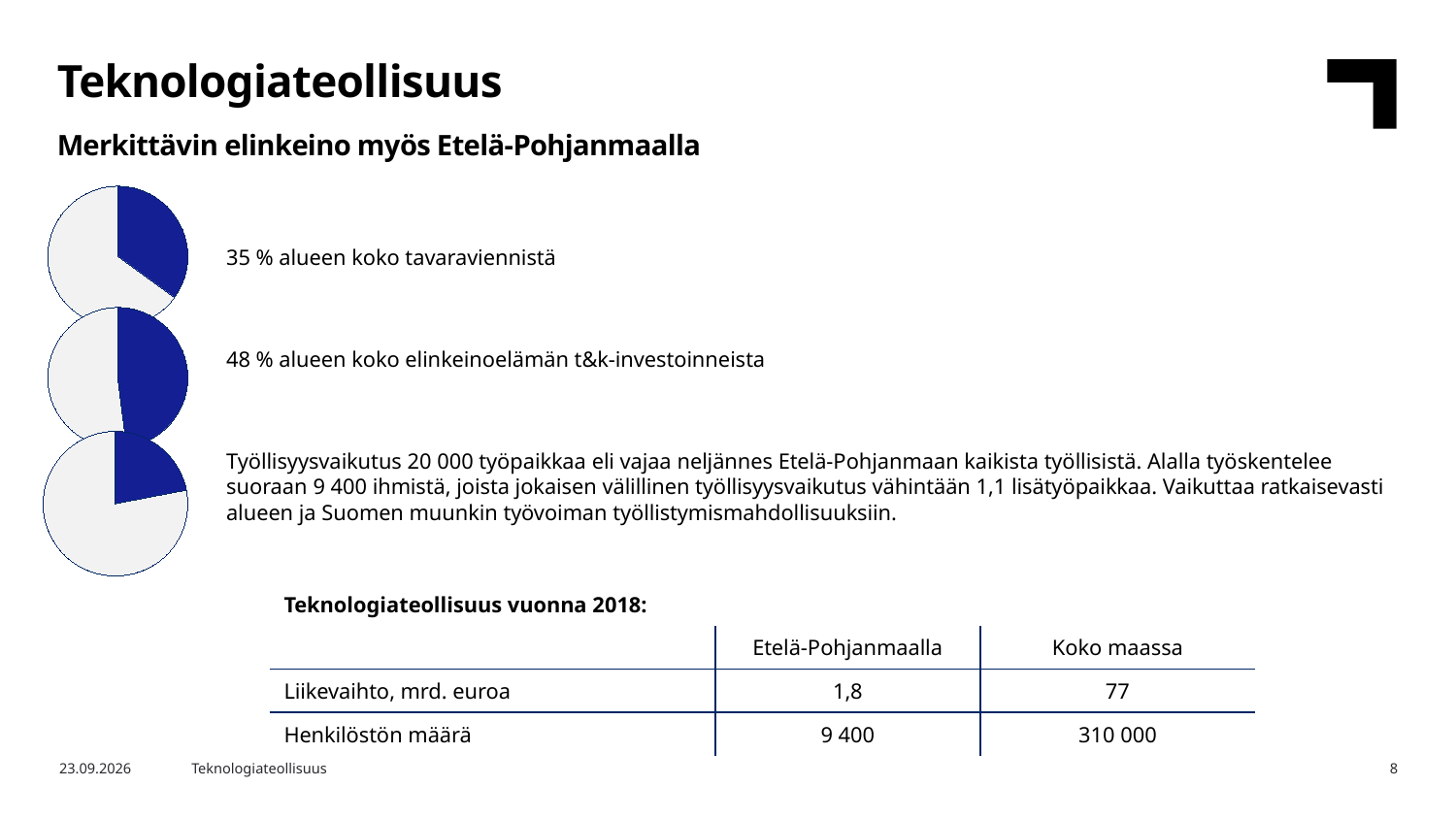
What kind of charts are shown on the left side of the slide? Pie charts Which of the three pie charts has the largest highlighted (blue) slice? The middle one (t&k-investoinnit, 48 %) How many pie charts are on the slide? 3 What colour is used for the highlighted slice in each pie chart? Blue According to the middle pie chart, what share of the region's business R&D investments does the technology industry account for? 48 % Which of the three pie charts has the smallest highlighted (blue) slice? The bottom one (työllisyysvaikutus) According to the top pie chart, what share of the region's total goods exports does the technology industry account for? 35 % What is the main title of the slide containing the pie charts? Teknologiateollisuus Which is larger: the technology industry's share of goods exports or its share of R&D investments? Share of R&D investments (48 %) What is the difference in percentage points between the R&D investment share (48 %) and the goods export share (35 %)? 13 percentage points